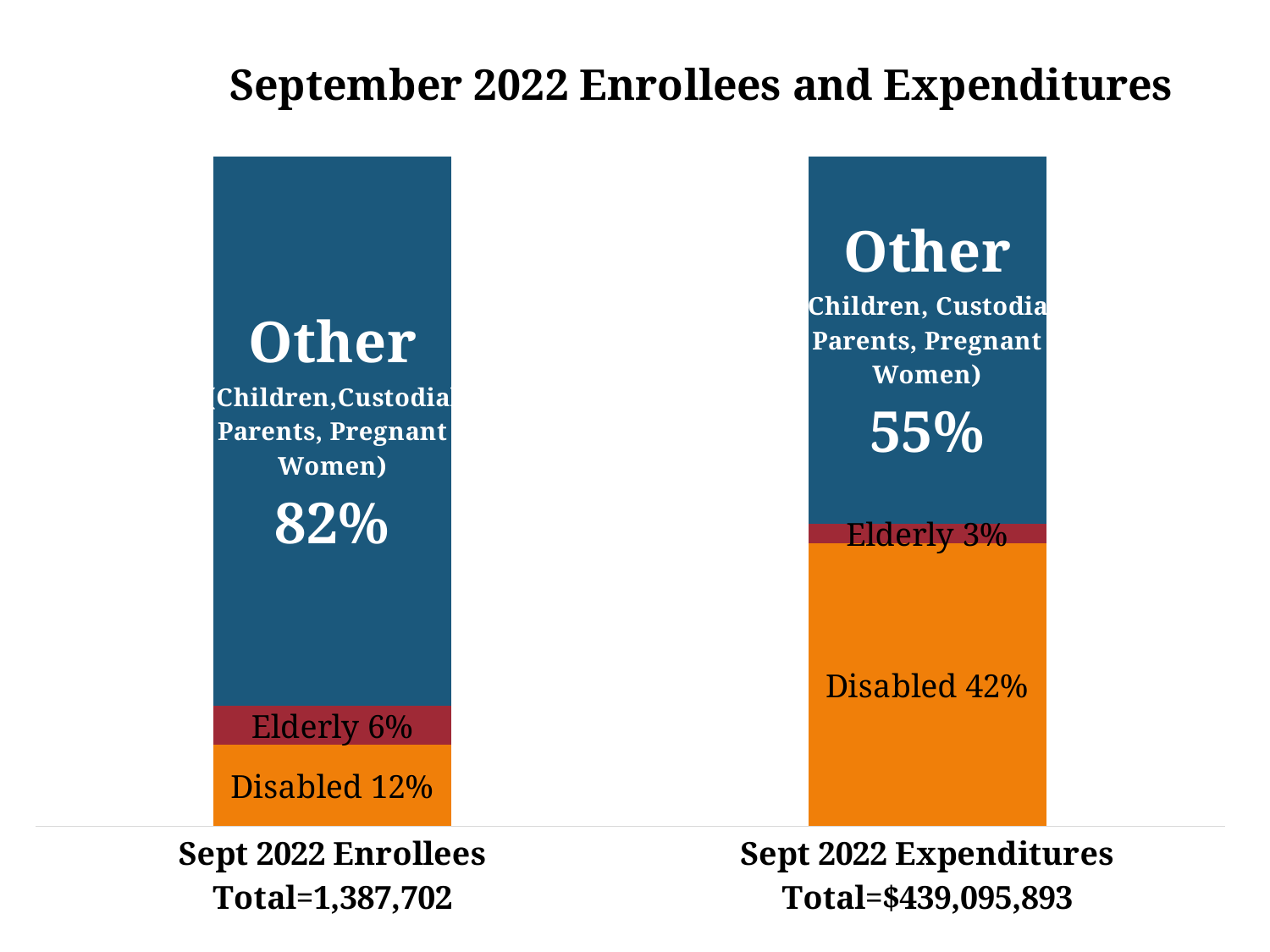
Is the Other share larger for Sept 2022 Enrollees or Sept 2022 Expenditures? Sept 2022 Enrollees Which group has the smallest share of Sept 2022 Expenditures? Elderly How many segments make up each stacked bar? 3 What share of Sept 2022 Expenditures is Elderly? 3% Which group has the largest share of Sept 2022 Enrollees? Other (Children, Custodial Parents, Pregnant Women) What share of Sept 2022 Enrollees is Elderly? 6% What share of Sept 2022 Enrollees is Disabled? 12% What is the total shown for Sept 2022 Expenditures? $439,095,893 What share of Sept 2022 Expenditures is Other (Children, Custodial Parents, Pregnant Women)? 55% What is the difference between the Disabled share of Sept 2022 Expenditures and the Disabled share of Sept 2022 Enrollees? 30% How many bars are shown in the chart? 2 What kind of chart is shown on the slide? Stacked bar chart